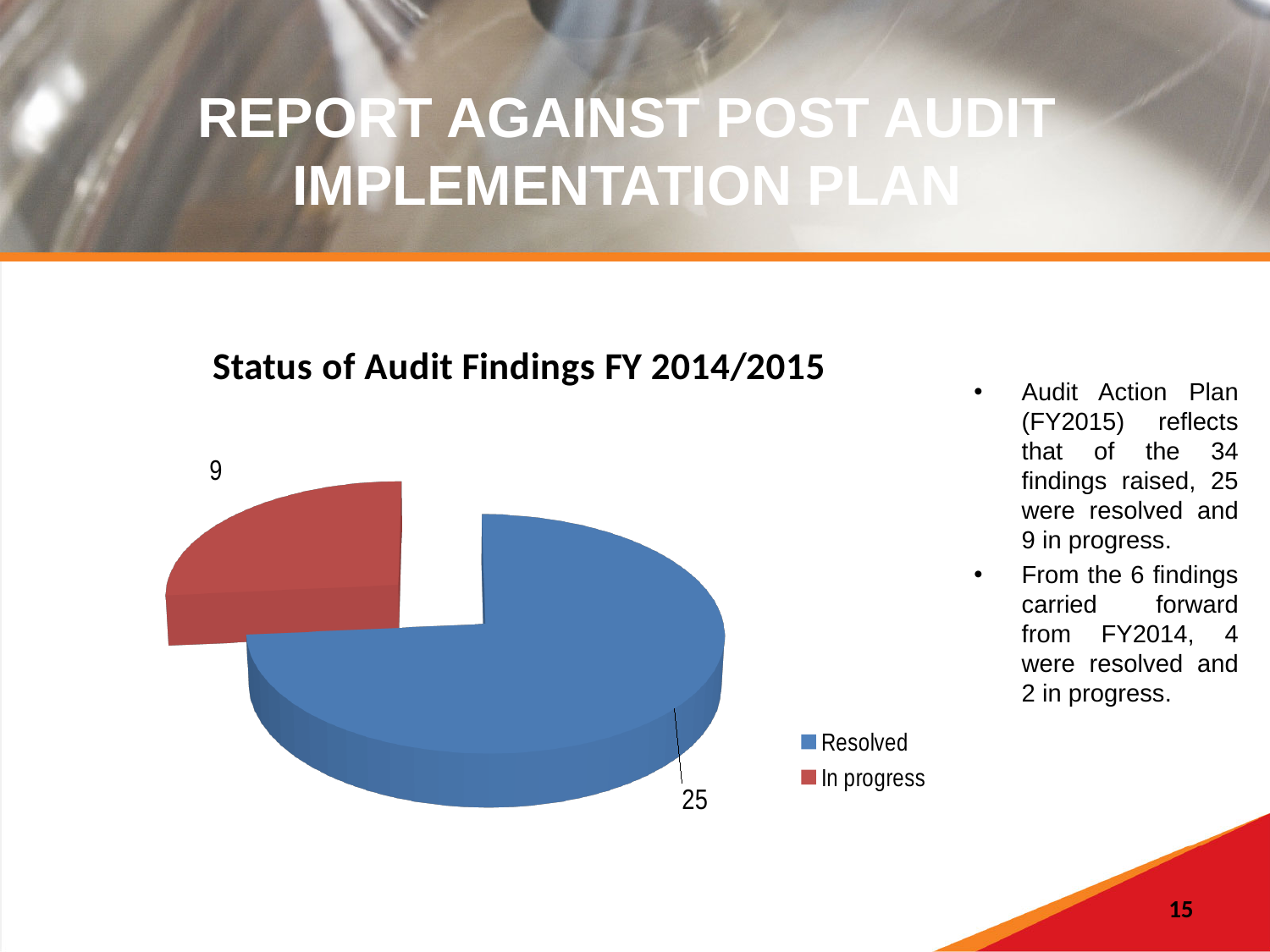
Which category has the smallest slice? In progress Which is larger, Resolved or In progress? Resolved What is the title of the chart? Status of Audit Findings FY 2014/2015 How many entries does the legend list? 2 What colour is the In progress slice? Red How many categories does the pie chart have? 2 What is the difference between the Resolved and In progress values? 16 What is the value for In progress? 9 What is the value for Resolved? 25 Which category has the largest slice? Resolved What is the total of all slices in the pie chart? 34 What type of chart is shown on the slide? Pie chart